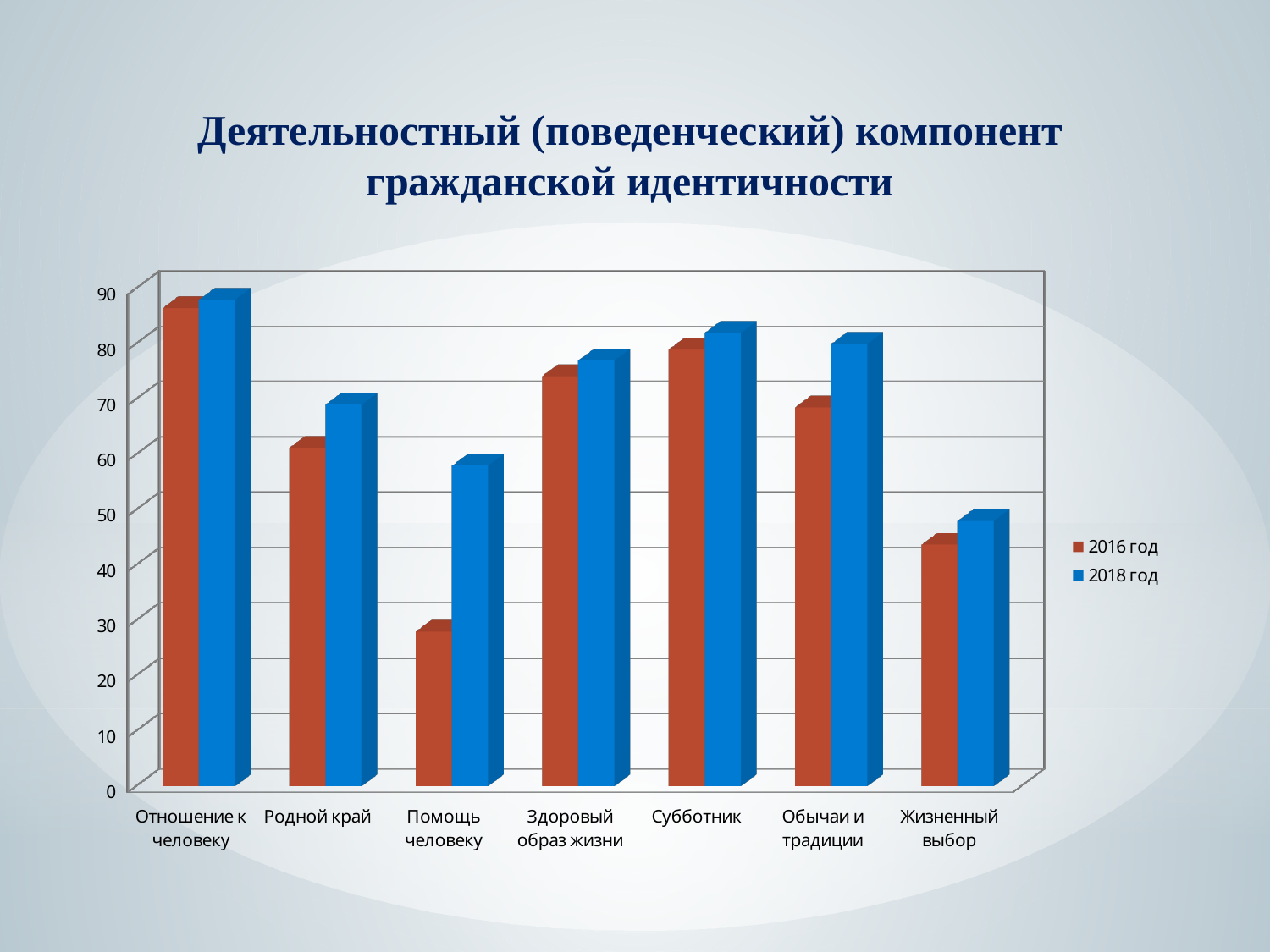
Is the value for Помощь человеку in 2016 год greater or less than 40? less Is the value for Обычаи и традиции in 2018 год greater or less than 70? greater How many series does the legend list? 2 Which category has the highest value for 2016 год? Отношение к человеку Is the value for Помощь человеку in 2018 год greater or less than 50? greater What kind of chart is shown on the slide? bar chart Which category has the highest value for 2018 год? Отношение к человеку Which category has the lowest value for 2016 год? Помощь человеку Which category has the lowest value for 2018 год? Жизненный выбор How many categories are shown on the x axis of the chart? 7 For Помощь человеку, which series has the larger value, 2016 год or 2018 год? 2018 год What are the two series listed in the legend? 2016 год and 2018 год